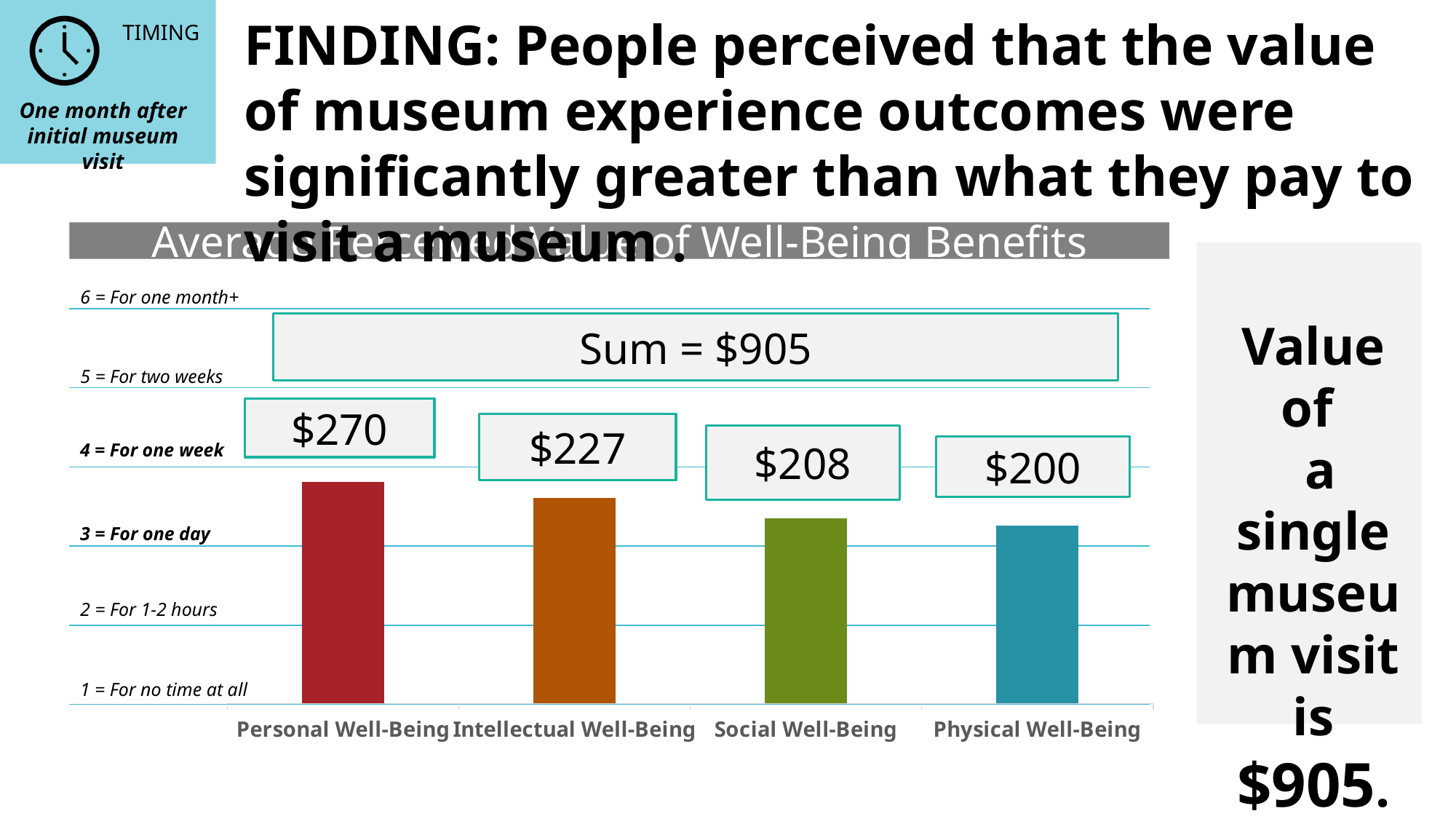
What is the sum of the four values shown in the chart? $905 What is the value shown for Physical Well-Being? $200 Which category has the highest value? Personal Well-Being Do the values rise or fall from left to right across the categories? Fall How many categories are shown in the chart? 4 What is the value shown for Personal Well-Being? $270 What is the difference between the values for Personal Well-Being and Physical Well-Being? $70 What is the value shown for Social Well-Being? $208 Which is larger, the value for Intellectual Well-Being or Social Well-Being? Intellectual Well-Being Which category has the lowest value? Physical Well-Being What is the value shown for Intellectual Well-Being? $227 What kind of chart is shown on the slide? Bar chart